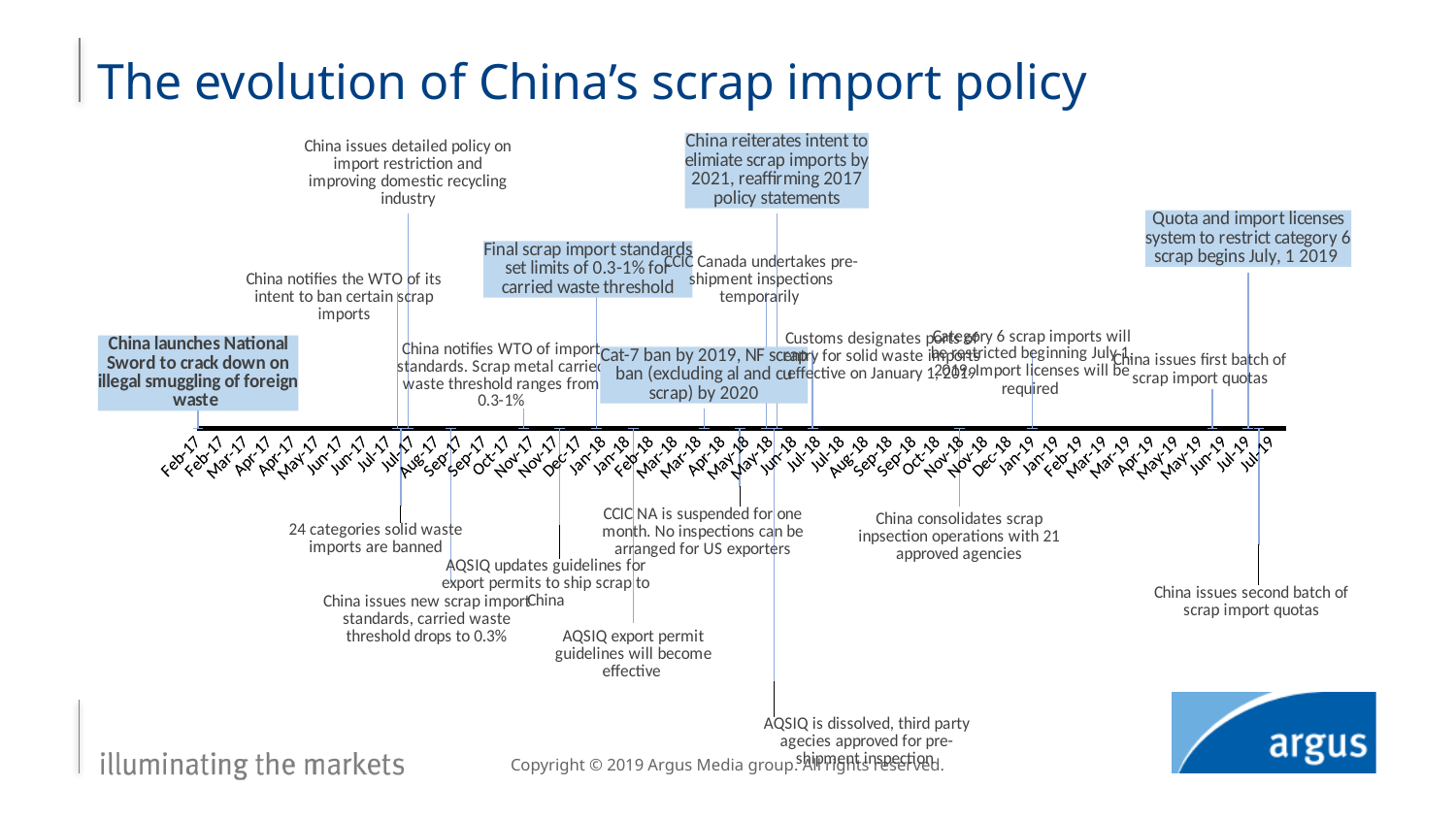
According to the timeline, on what date does the quota and import licenses system to restrict category 6 scrap begin? July, 1 2019 Which event is placed at the far left of the timeline, highlighted in a blue box? China launches National Sword to crack down on illegal smuggling of foreign waste According to the timeline, with how many approved agencies does China consolidate scrap inspection operations? 21 According to the timeline, how many categories of solid waste imports are banned in the 2017 event? 24 categories According to the timeline, to what level does the carried waste threshold drop under China's new scrap import standards? 0.3% What kind of chart is shown on the slide? Timeline According to the timeline, by what year is the Cat-7 ban scheduled? 2019 What is the first month label on the timeline axis? Feb-17 What is the title of the chart on the slide? The evolution of China's scrap import policy What is the last month label on the timeline axis? Jul-19 According to the timeline, by what year does China reiterate its intent to eliminate scrap imports? 2021 According to the timeline, what range of carried waste threshold limits do the final scrap import standards set? 0.3-1%